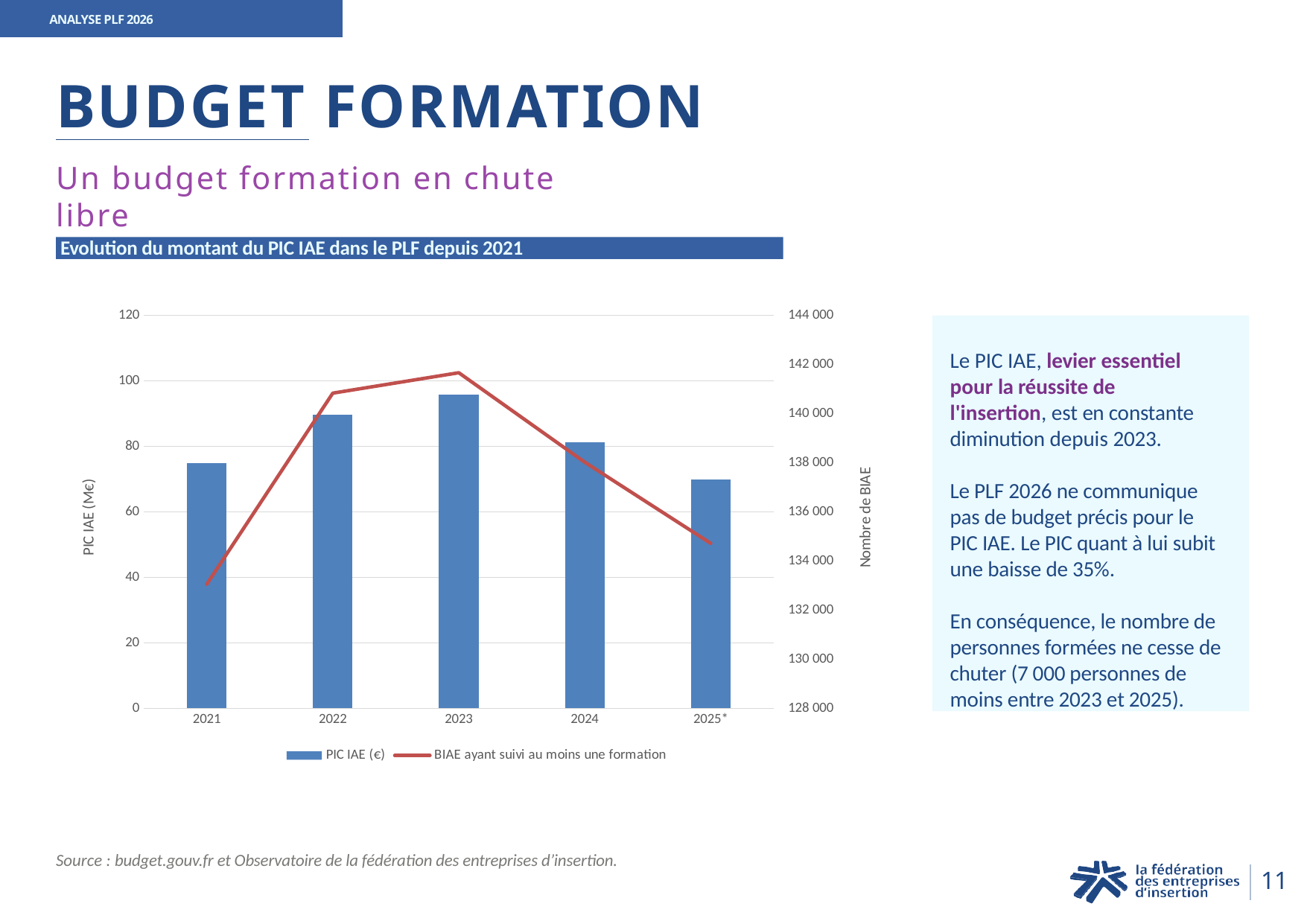
Do the PIC IAE (€) bars rise or fall from 2023 to 2025*? fall What is the label of the right-hand vertical axis? Nombre de BIAE Which year has the lowest PIC IAE (€) bar? 2025* What is the title of the chart? Evolution du montant du PIC IAE dans le PLF depuis 2021 Which year has the larger PIC IAE (€) bar, 2022 or 2024? 2022 How many series does the chart legend list? 2 How many years are shown on the x axis of the chart? 5 Is the BIAE ayant suivi au moins une formation value for 2023 greater or less than 140 000? greater Is the PIC IAE (€) value for 2021 greater or less than 80? less Which year has the highest PIC IAE (€) bar? 2023 What kind of chart is used to show the PIC IAE (€) series? Bar chart Is the PIC IAE (€) value for 2023 greater or less than 80? greater